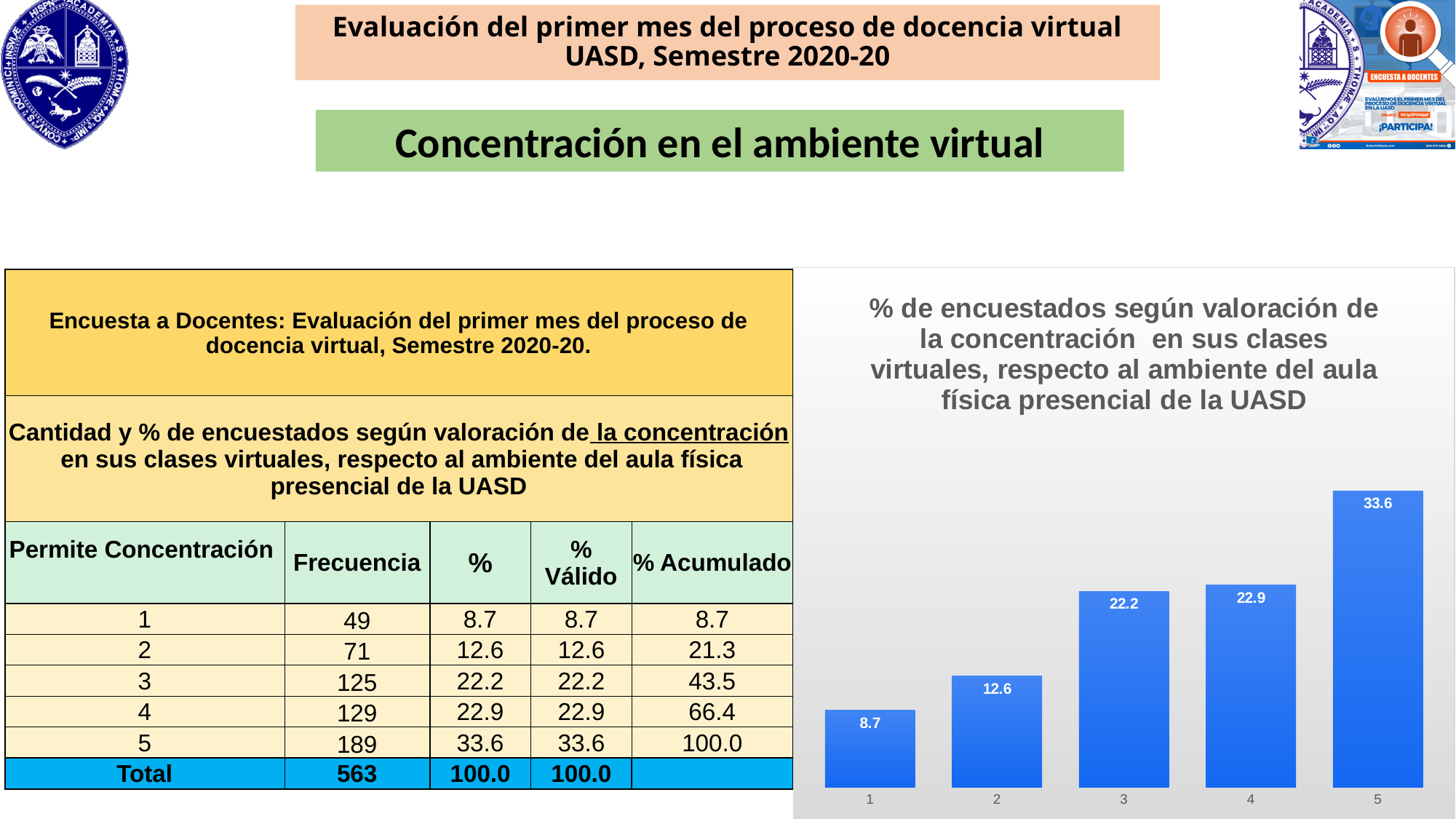
What is the difference between the values for category 2 and category 1? 3.9 Which category has the lowest value in the bar chart? 1 What is the value for category 5 in the bar chart? 33.6 What is the title of the bar chart? % de encuestados según valoración de la concentración en sus clases virtuales, respecto al ambiente del aula física presencial de la UASD Do the values rise or fall from category 1 to category 5 along the x axis? rise Which is larger, the value for category 2 or the value for category 3? 3 What type of chart is shown on the slide? bar chart What is the value for category 3 in the bar chart? 22.2 What is the difference between the values for category 5 and category 1? 24.9 How many categories are shown on the x axis of the bar chart? 5 What is the value for category 1 in the bar chart? 8.7 Which category has the highest value in the bar chart? 5